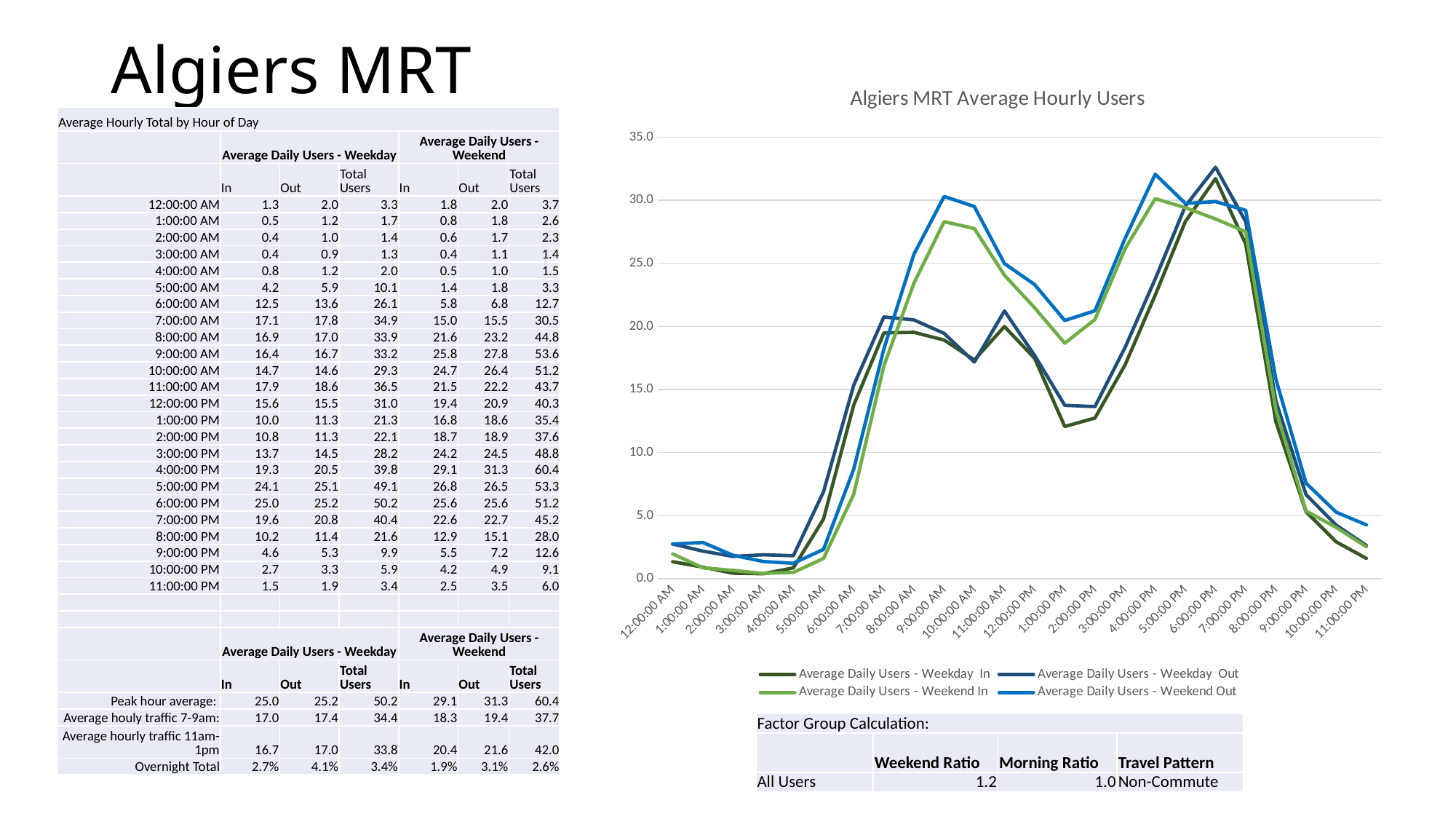
Do the values for Average Daily Users - Weekday In rise or fall from 6:00:00 PM to 9:00:00 PM? fall What is the highest value shown on the chart's vertical axis? 35.0 Is the value for Average Daily Users - Weekday In at 1:00:00 PM greater or less than 15.0? less Is the value for Average Daily Users - Weekday Out at 11:00:00 AM greater or less than 15.0? greater Is the value for Average Daily Users - Weekend Out at 9:00:00 AM greater or less than 25.0? greater At 1:00:00 PM, which is larger: Average Daily Users - Weekend In or Average Daily Users - Weekday In? Average Daily Users - Weekend In What kind of chart is shown on the slide? line chart What is the title of the chart? Algiers MRT Average Hourly Users At 9:00:00 AM, which is larger: Average Daily Users - Weekend Out or Average Daily Users - Weekday In? Average Daily Users - Weekend Out How many series does the chart legend list? 4 How many hourly categories are shown along the x axis of the chart? 24